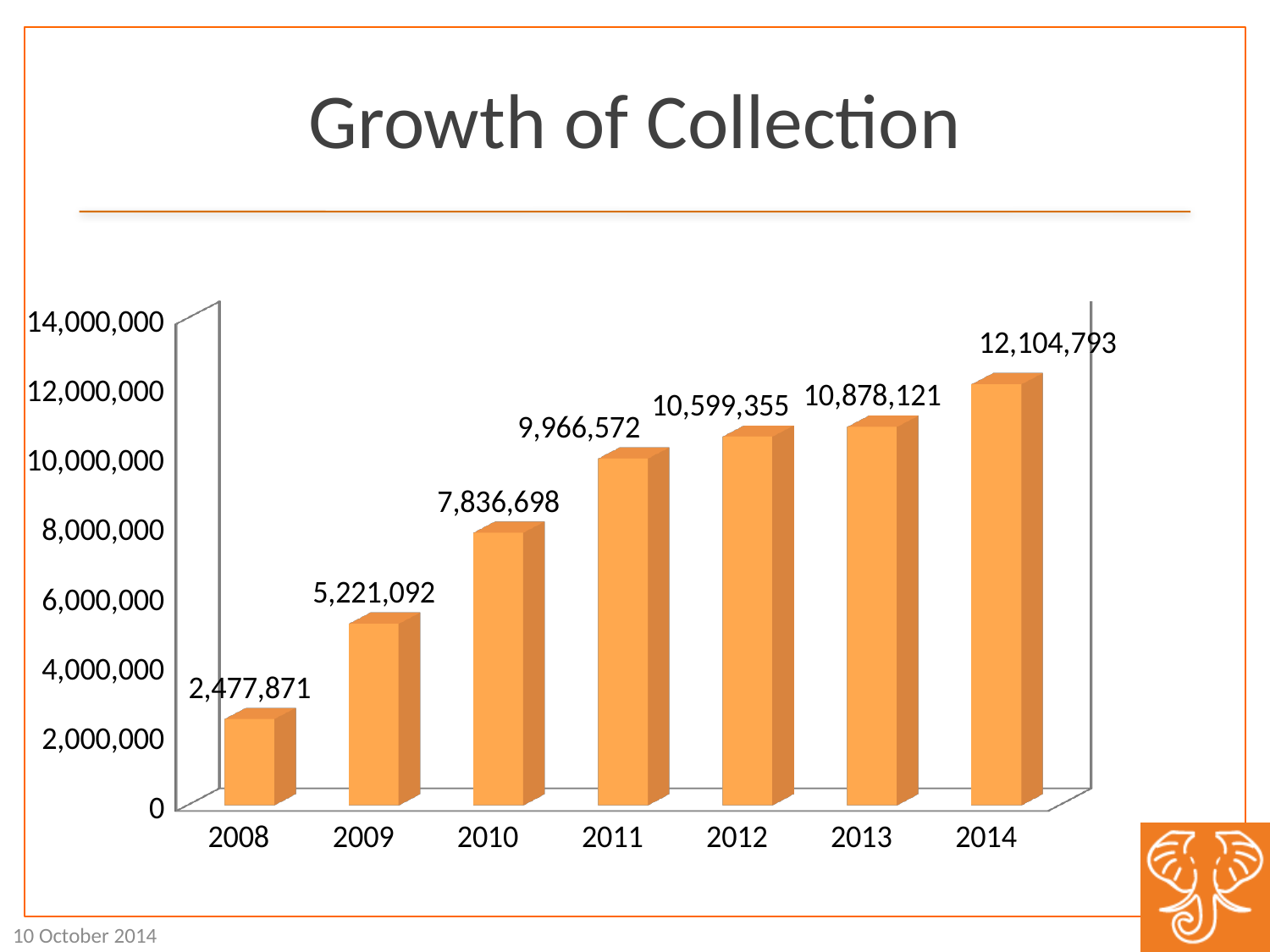
What is the value for 2008? 2,477,871 Do the values rise or fall from 2008 to 2014? rise Which year has the lowest value? 2008 Which is larger, the value for 2010 or the value for 2012? 2012 Which year has the highest value? 2014 What kind of chart is shown on the slide? bar chart What is the difference between the values for 2014 and 2008? 9,626,922 Is the value for 2010 greater or less than 8,000,000? less What is the difference between the values for 2013 and 2012? 278,766 How many years are shown on the x axis? 7 What is the value for 2011? 9,966,572 What is the value for 2014? 12,104,793